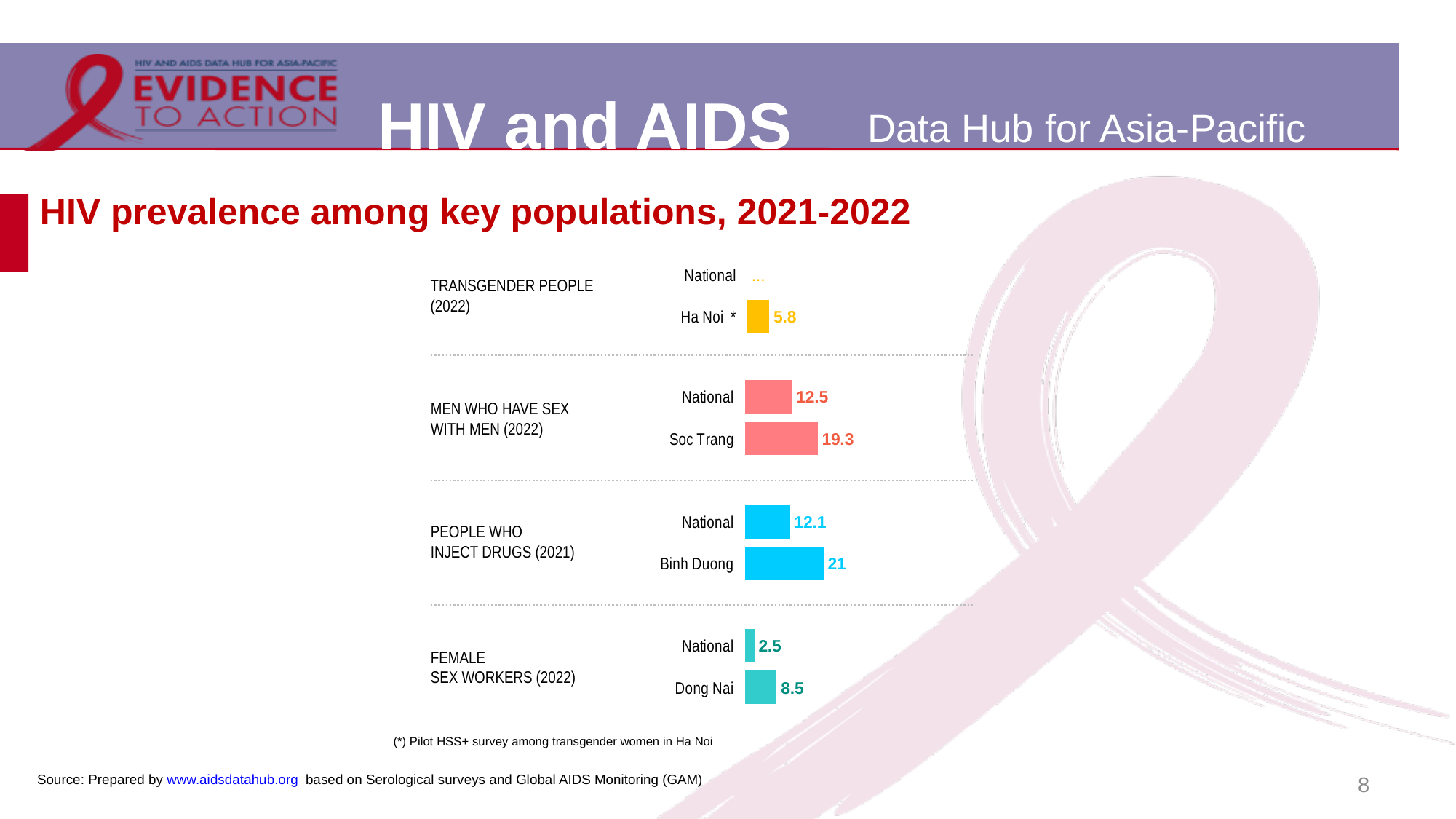
What kind of chart is used to show HIV prevalence among key populations? Bar chart What is the difference between the Binh Duong and national values for people who inject drugs (2021)? 8.9 What is the HIV prevalence value shown for Ha Noi among transgender people (2022)? 5.8 What is the HIV prevalence value shown for Dong Nai among female sex workers (2022)? 8.5 What is the HIV prevalence value shown for Soc Trang among men who have sex with men (2022)? 19.3 What is the national HIV prevalence value shown for men who have sex with men (2022)? 12.5 Which labelled bar on the slide has the highest HIV prevalence value? Binh Duong (people who inject drugs) What is the difference between the Soc Trang and national values for men who have sex with men (2022)? 6.8 What is the HIV prevalence value shown for Binh Duong among people who inject drugs (2021)? 21 What is shown instead of a value for the national bar for transgender people (2022)? ... Which is larger: the national value for men who have sex with men (12.5) or the national value for people who inject drugs (12.1)? Men who have sex with men What is the national HIV prevalence value shown for female sex workers (2022)? 2.5